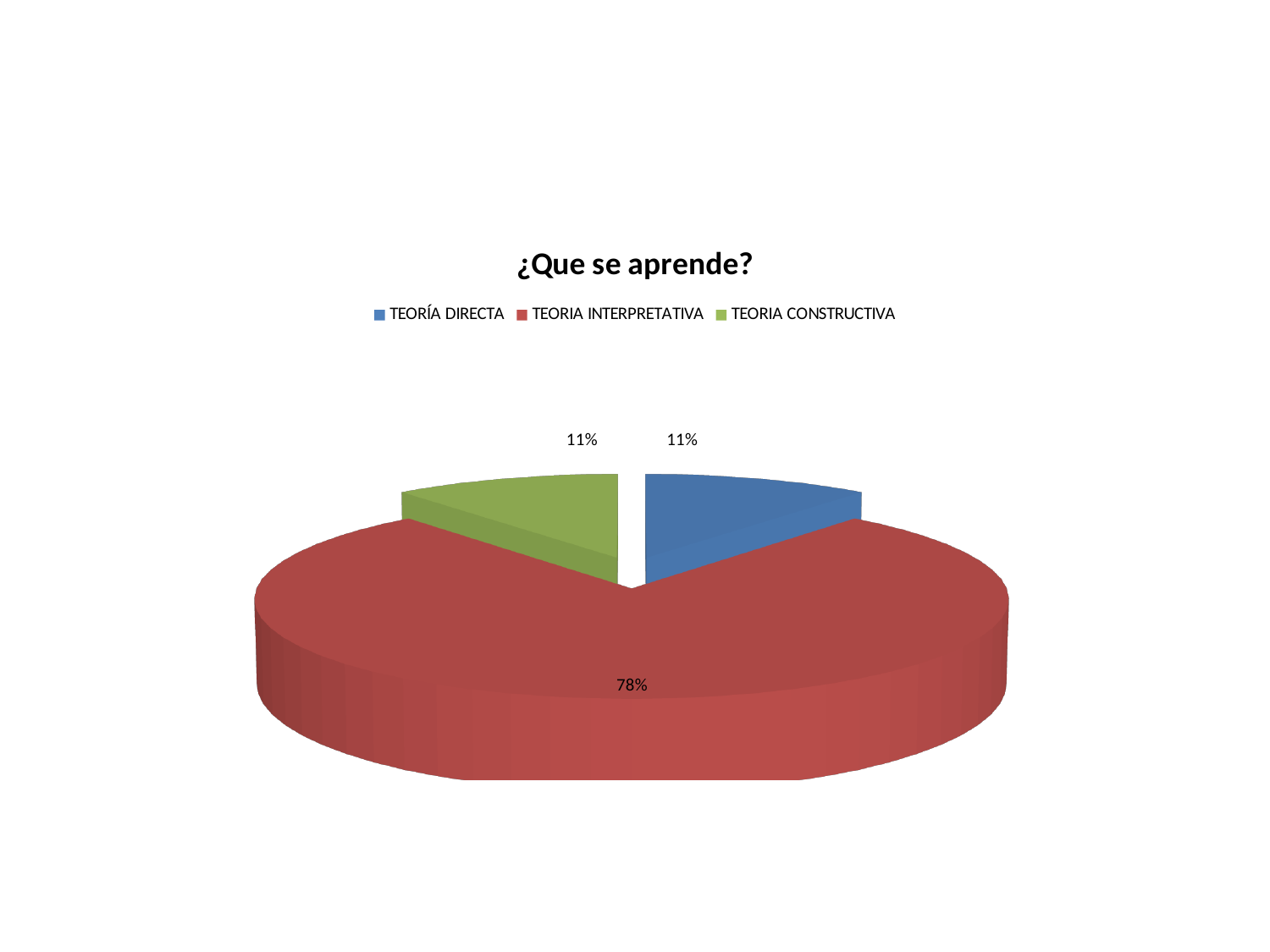
What is the title of the chart? ¿Que se aprende? What is the difference in percentage points between TEORIA INTERPRETATIVA and TEORÍA DIRECTA? 67 What percentage of the pie does TEORIA CONSTRUCTIVA represent? 11% What colour is the slice for TEORIA CONSTRUCTIVA? Green Which category has the largest share of the pie? TEORIA INTERPRETATIVA How many entries does the legend list? 3 Which is larger, the share for TEORIA INTERPRETATIVA or the share for TEORIA CONSTRUCTIVA? TEORIA INTERPRETATIVA What percentage of the pie does TEORIA INTERPRETATIVA represent? 78% How many slices does the pie chart have? 3 What kind of chart is shown on the slide? Pie chart What percentage of the pie does TEORÍA DIRECTA represent? 11%